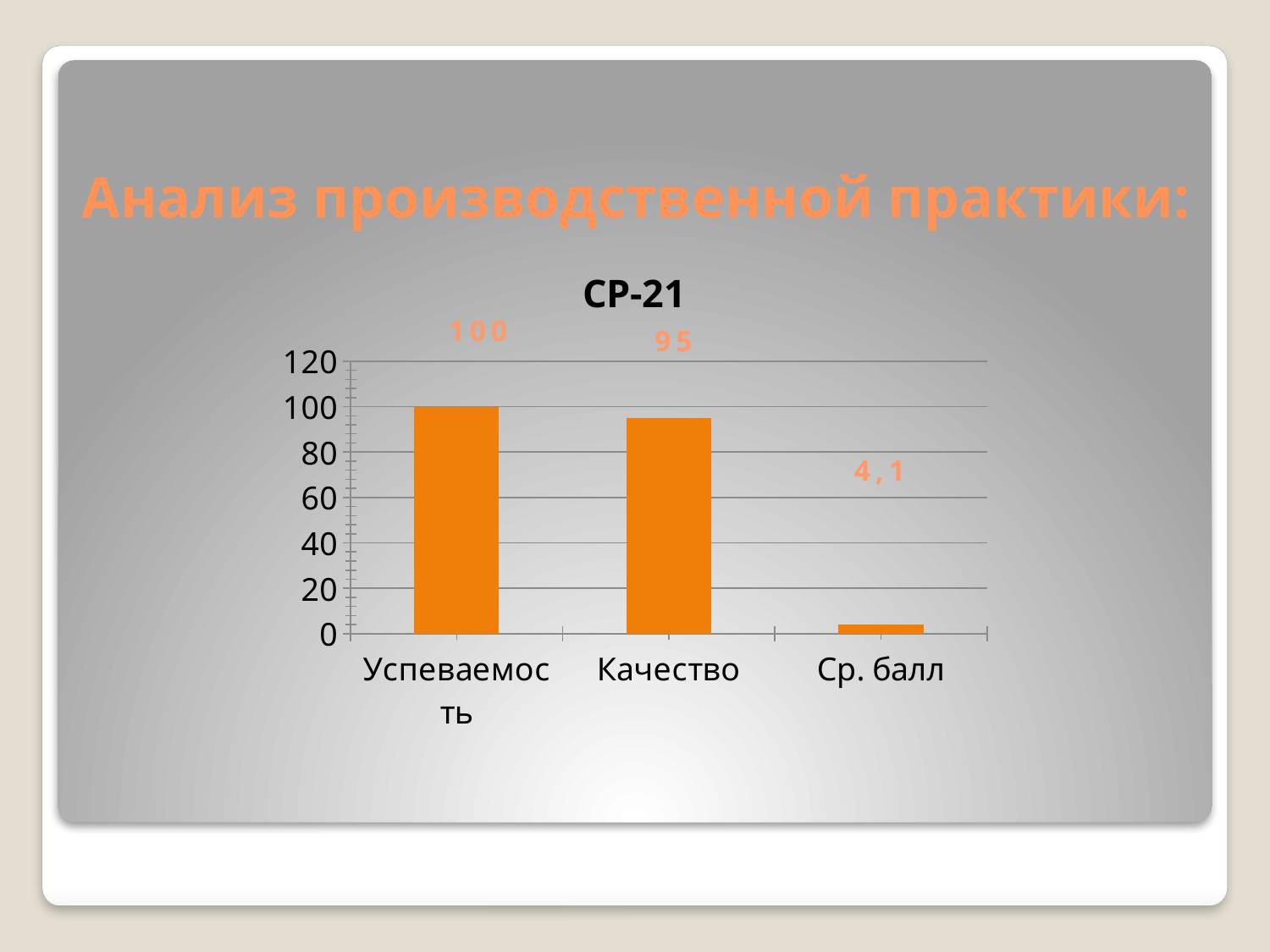
Which category has the highest value? Успеваемость What is the value for Успеваемость? 100 How many categories are shown on the x axis? 3 What is the difference between the values for Успеваемость and Качество? 5 Is the value for Качество greater or less than 80? greater What is the value for Ср. балл? 4,1 What kind of chart is shown on the slide? bar chart Which is larger, the value for Качество or the value for Ср. балл? Качество Is the value for Ср. балл greater or less than 20? less What is the value for Качество? 95 What is the title of the chart? СР-21 Which category has the lowest value? Ср. балл